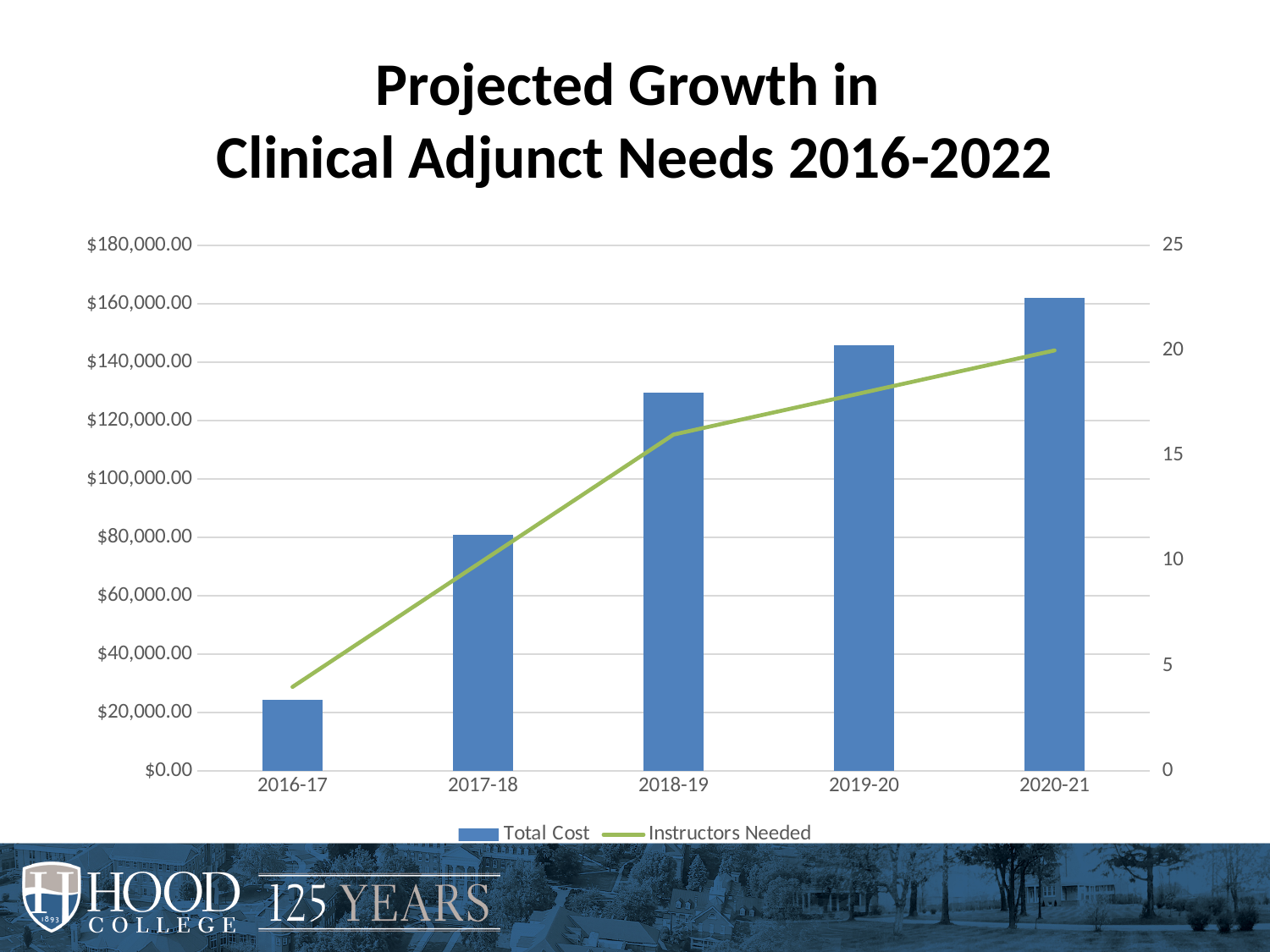
What kind of chart is shown on the slide? A bar chart combined with a line chart How many academic years are shown on the x axis? 5 Which is larger, the Total Cost for 2018-19 or for 2019-20? 2019-20 Is the Total Cost for 2016-17 greater or less than $40,000.00? less How many series does the legend list? 2 Which year has the lowest Total Cost? 2016-17 What is the title of the chart? Projected Growth in Clinical Adjunct Needs 2016-2022 Which year has the highest Total Cost? 2020-21 Is the number of Instructors Needed in 2018-19 greater or less than 15? greater Do the Instructors Needed values rise or fall from 2016-17 to 2020-21? rise Is the Total Cost for 2017-18 greater or less than $100,000.00? less